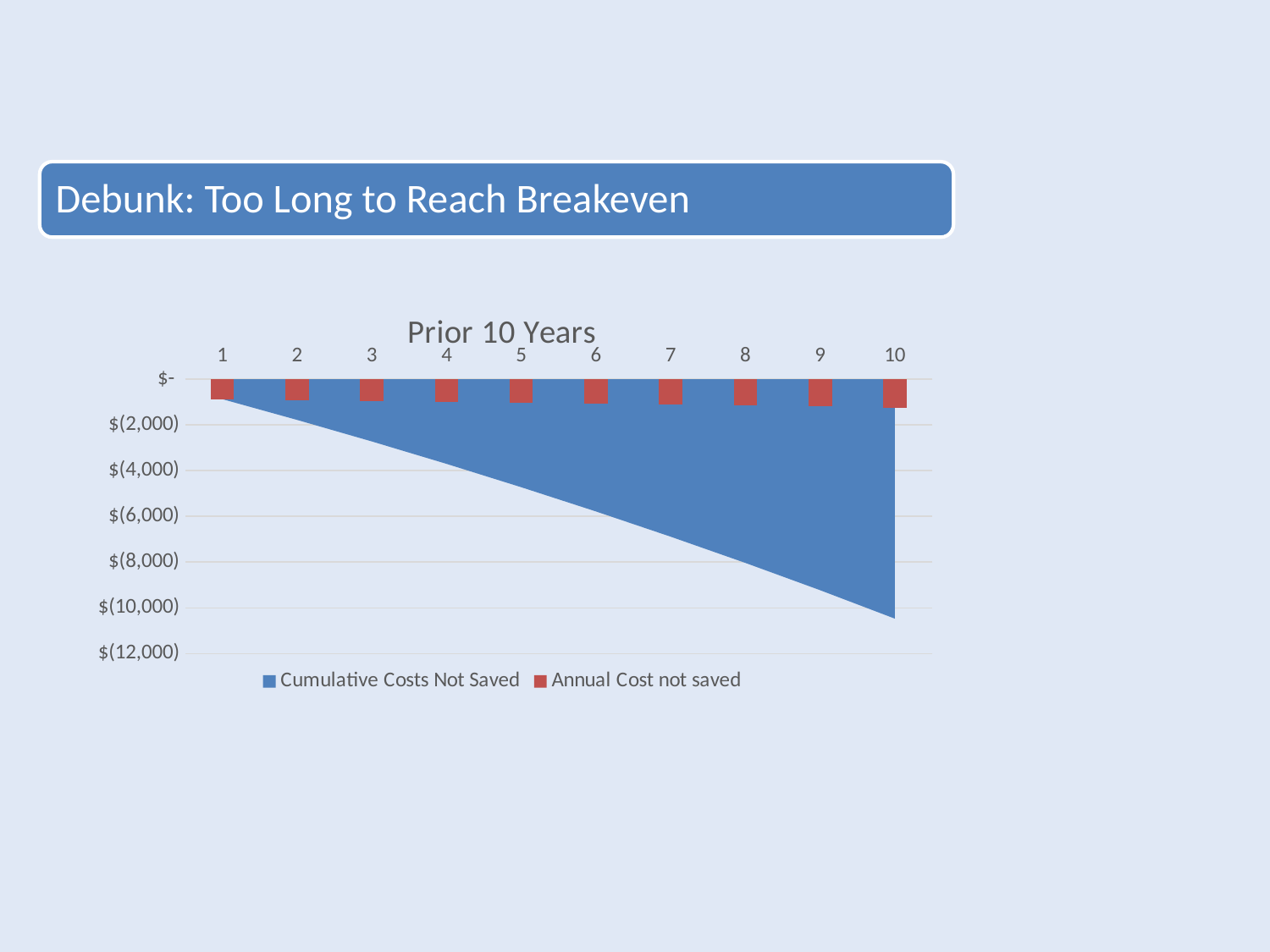
What kind of chart is used to plot the Annual Cost not saved series? bar chart Is the Cumulative Costs Not Saved value at year 10 greater or less than $(10,000)? less What kind of chart is used to plot the Cumulative Costs Not Saved series? area chart In which year is the Cumulative Costs Not Saved value lowest (most negative)? 10 Is the Annual Cost not saved value at year 1 greater or less than $(2,000)? greater Is the Cumulative Costs Not Saved value at year 5 greater or less than $(4,000)? less How many years are shown along the x axis of the chart? 10 How many series does the chart legend list? 2 Which colour represents the Annual Cost not saved series in the legend? red What is the title of the chart? Prior 10 Years In which year is the Cumulative Costs Not Saved value highest (least negative)? 1 Does the Cumulative Costs Not Saved series rise or fall as the years go from 1 to 10? fall